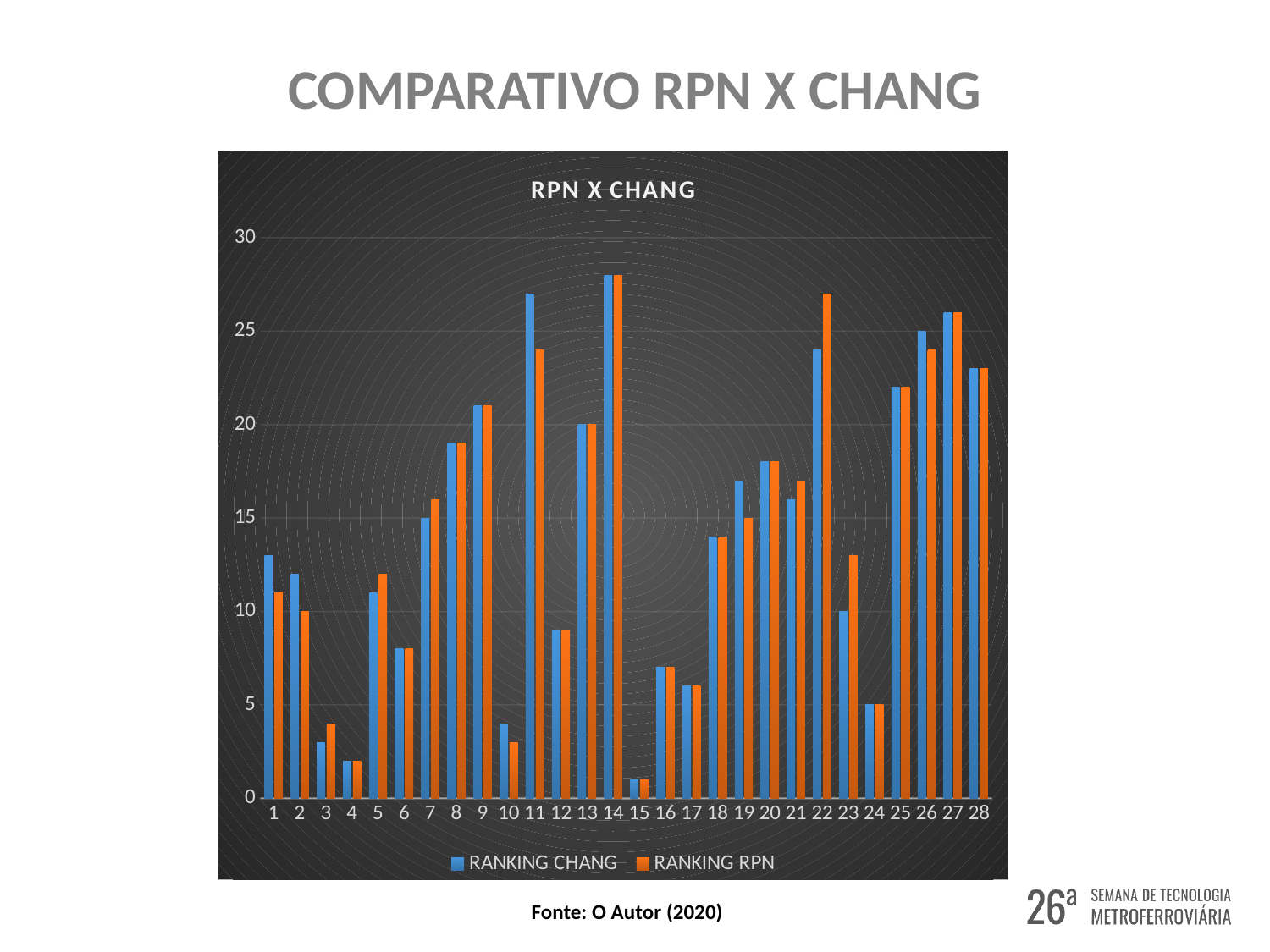
What kind of chart is shown on the slide? bar chart How many series does the legend list? 2 What is the RANKING CHANG value for category 23? 10 Is the RANKING RPN value for category 15 greater or less than 5? less For category 22, which series has the larger value, RANKING CHANG or RANKING RPN? RANKING RPN How many categories are shown on the x axis? 28 Which series is shown in orange? RANKING RPN What is the RANKING CHANG value for category 13? 20 What is the RANKING RPN value for category 24? 5 Is the RANKING CHANG value for category 14 greater or less than 25? greater For category 11, which series has the larger value, RANKING CHANG or RANKING RPN? RANKING CHANG What is the title of the chart? RPN X CHANG